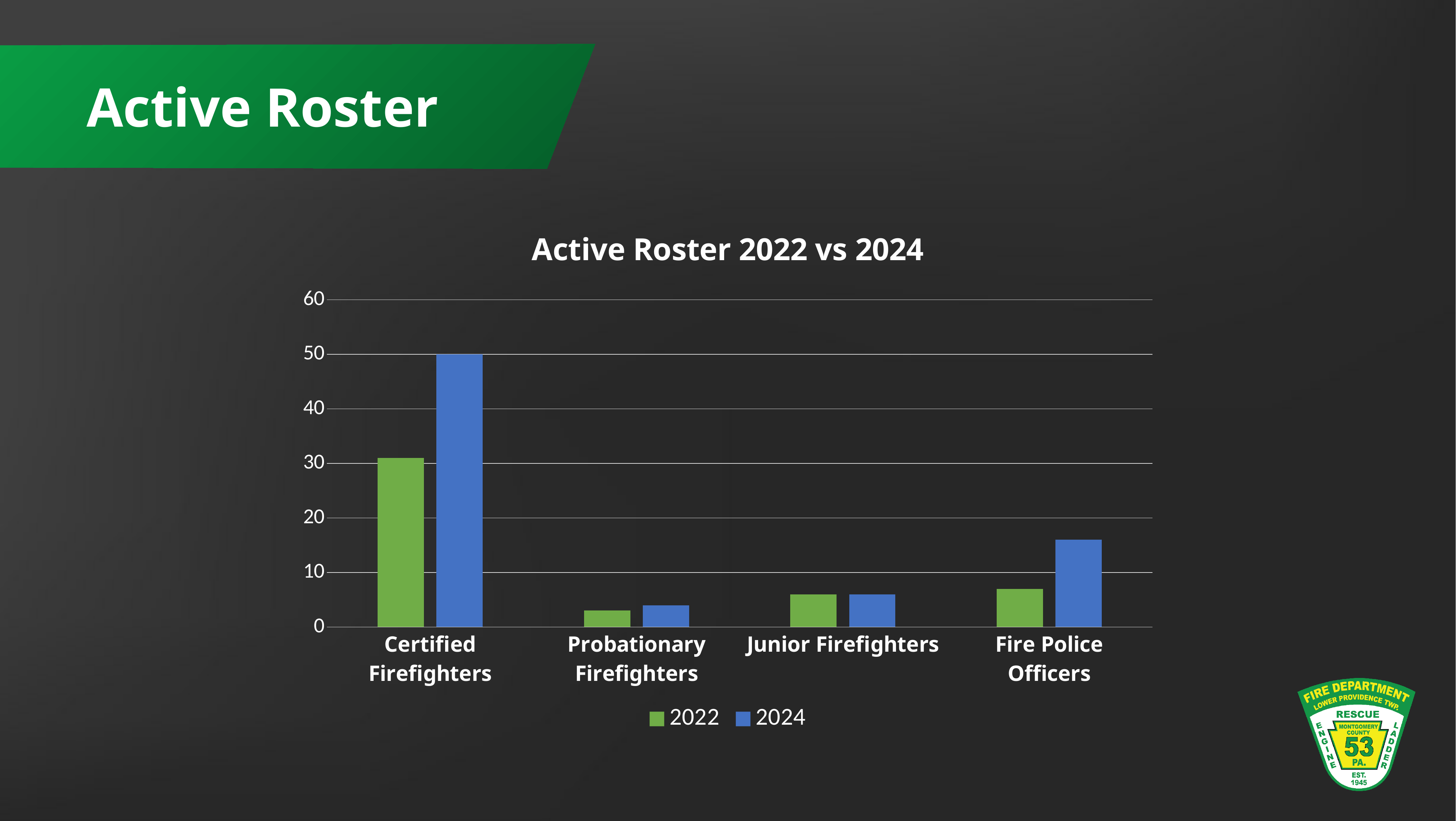
For Certified Firefighters, is the 2022 value or the 2024 value larger? 2024 Is the 2024 value for Fire Police Officers greater or less than 10? greater For Fire Police Officers, is the 2022 value or the 2024 value larger? 2024 Which colour represents the 2022 series in the legend? Green What is the title of the chart? Active Roster 2022 vs 2024 Is the 2022 value for Certified Firefighters greater or less than 20? greater Which category has the highest 2024 value? Certified Firefighters How many series does the legend list? 2 How many categories are shown on the x axis? 4 What type of chart is shown on the slide? Bar chart Which category has the lowest 2022 value? Probationary Firefighters What is the 2024 value for Certified Firefighters? 50